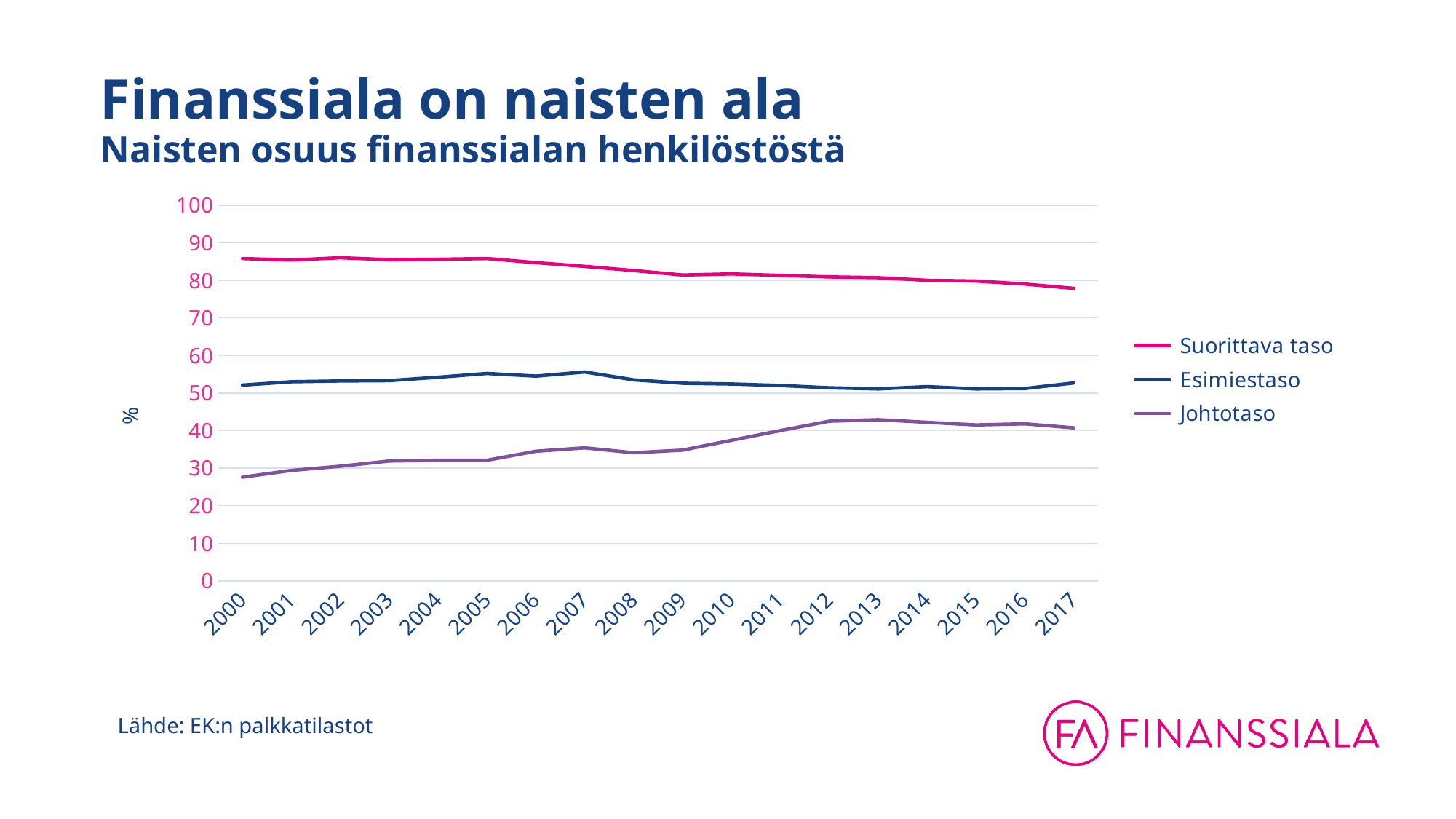
How many series does the legend list? 3 Does the Suorittava taso line rise or fall from 2000 to 2017? fall How many years are shown on the x axis? 18 Is the value for Johtotaso in 2000 greater or less than 30? less What kind of chart is shown on the slide? line chart In 2010, which is larger: Esimiestaso or Johtotaso? Esimiestaso Is the value for Johtotaso in 2013 greater or less than 40? greater Does the Johtotaso line rise or fall from 2000 to 2017? rise Which series has the lowest values throughout the chart? Johtotaso Is the value for Suorittava taso in 2000 greater or less than 80? greater Which series has the highest values throughout the chart? Suorittava taso What is the subtitle of the chart? Naisten osuus finanssialan henkilöstöstä